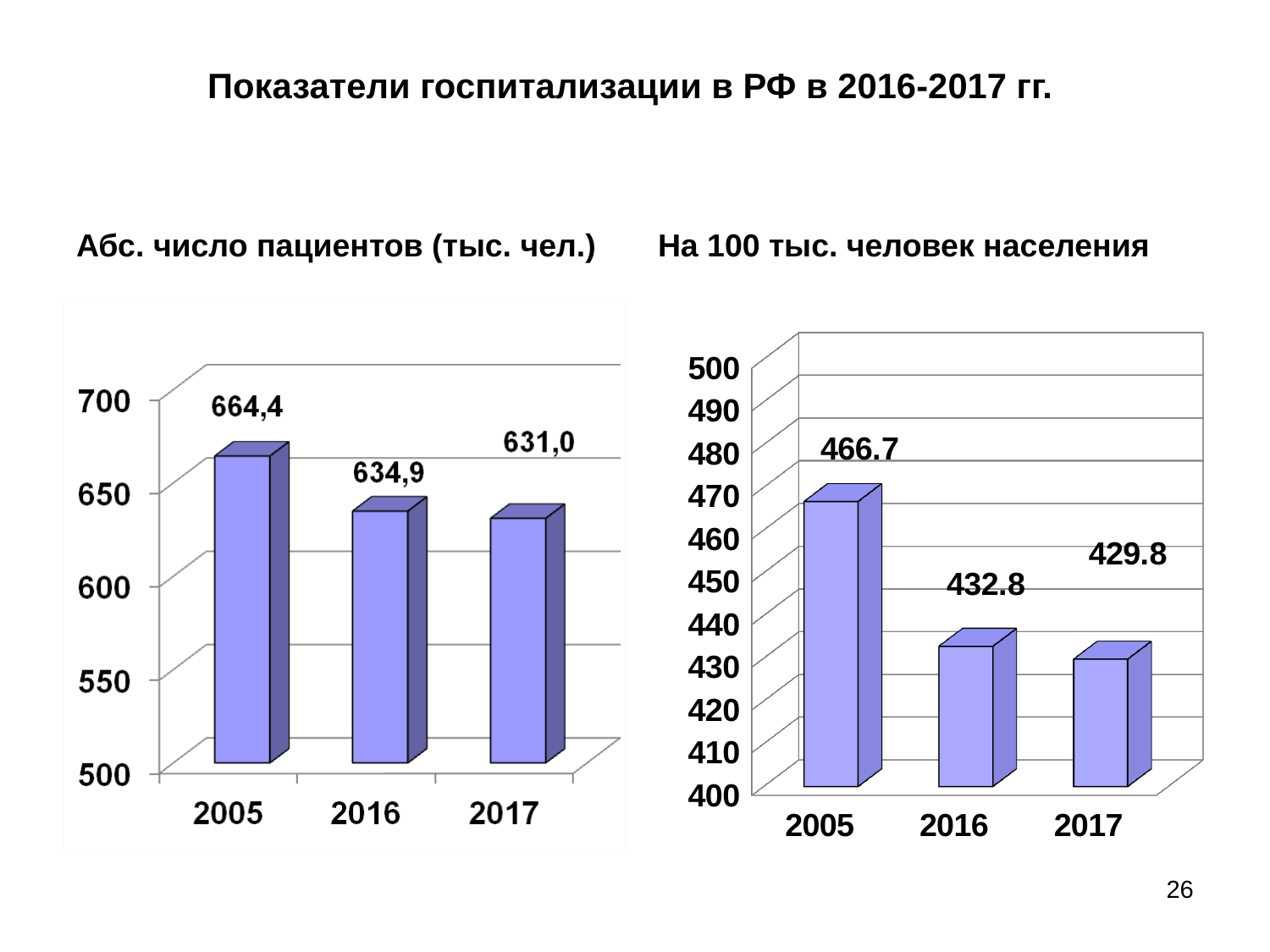
In the left chart (Абс. число пациентов), which year has the highest value? 2005 In the left chart (Абс. число пациентов), which is larger, the value for 2016 or the value for 2017? 2016 In the right chart (На 100 тыс. человек населения), do the values rise or fall from 2005 to 2017? fall What kind of chart is the left chart (Абс. число пациентов)? bar chart In the left chart (Абс. число пациентов), what is the value for 2017? 631,0 In the right chart (На 100 тыс. человек населения), what is the value for 2005? 466.7 In the left chart (Абс. число пациентов), what is the difference between the 2016 and 2017 values? 3,9 In the right chart (На 100 тыс. человек населения), what is the value for 2016? 432.8 In the left chart (Абс. число пациентов), what is the value for 2005? 664,4 In the right chart (На 100 тыс. человек населения), what is the difference between the 2005 and 2016 values? 33.9 In the right chart (На 100 тыс. человек населения), which year has the lowest value? 2017 How many years are shown on the x axis of the right chart (На 100 тыс. человек населения)? 3